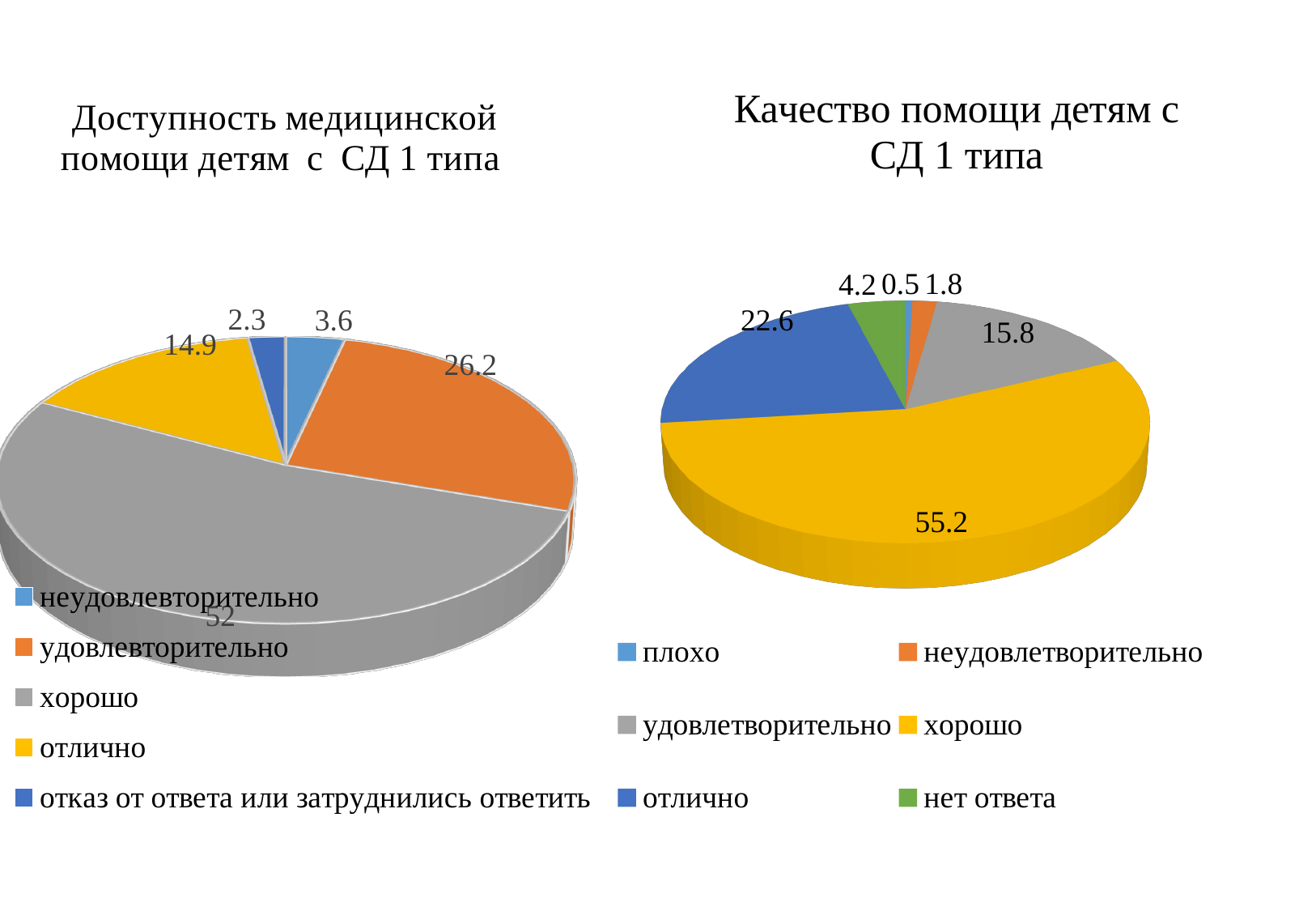
In the chart titled "Доступность медицинской помощи детям с СД 1 типа", what is the difference between the values for "удовлетворительно" and "отлично"? 11.3 In the chart titled "Качество помощи детям с СД 1 типа", what is the value for "отлично"? 22.6 In the chart titled "Доступность медицинской помощи детям с СД 1 типа", which category has the smallest slice? отказ от ответа или затруднились ответить In the chart titled "Качество помощи детям с СД 1 типа", which category has the largest slice? хорошо In the chart titled "Качество помощи детям с СД 1 типа", how many categories does the legend list? 6 In the chart titled "Доступность медицинской помощи детям с СД 1 типа", what is the value for "удовлетворительно"? 26.2 What type of chart is used for "Качество помощи детям с СД 1 типа"? Pie chart In the chart titled "Качество помощи детям с СД 1 типа", which is larger: the value for "удовлетворительно" or the value for "отлично"? отлично In the chart titled "Доступность медицинской помощи детям с СД 1 типа", how many categories does the legend list? 5 In the chart titled "Доступность медицинской помощи детям с СД 1 типа", what is the value for "хорошо"? 52 In the chart titled "Качество помощи детям с СД 1 типа", what is the value for "нет ответа"? 4.2 In the chart titled "Качество помощи детям с СД 1 типа", which category has the smallest slice? плохо